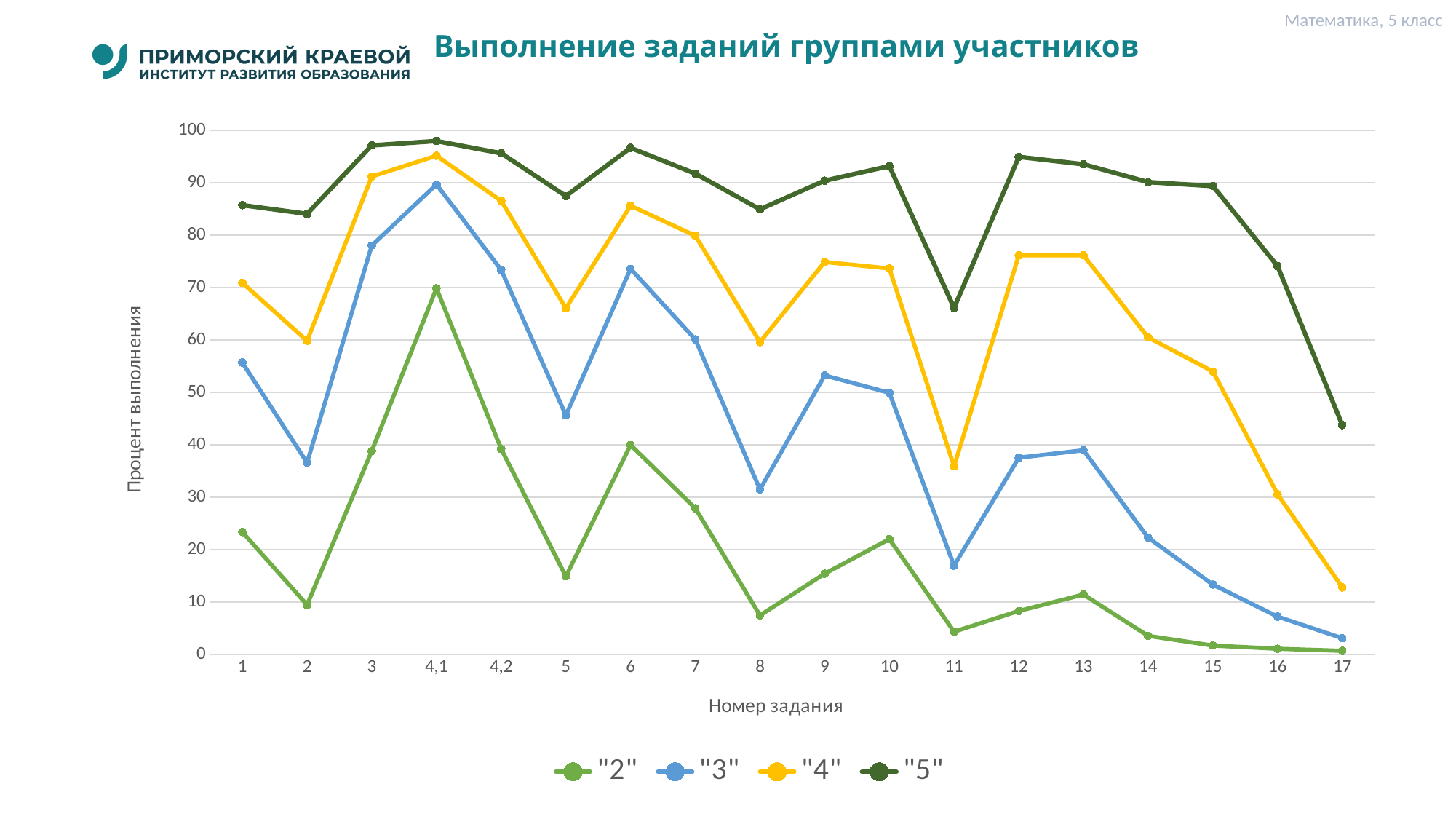
What kind of chart is shown on the slide? line chart For which task number does the "2" series reach its highest value? 4,1 Is the value of the "3" series for task 2 greater or less than 40? less How many series does the legend list? 4 For which task number does the "5" series reach its lowest value? 17 How many task numbers are shown along the x axis? 18 Do the values of the "2" series rise or fall from task 13 to task 17? fall For which task number does the "4" series reach its lowest value? 17 Is the value of the "5" series for task 17 greater or less than 50? less What is the title of the chart? Выполнение заданий группами участников Is the value of the "5" series for task 11 greater or less than 60? greater For task 8, which series has the larger value, "3" or "2"? "3"